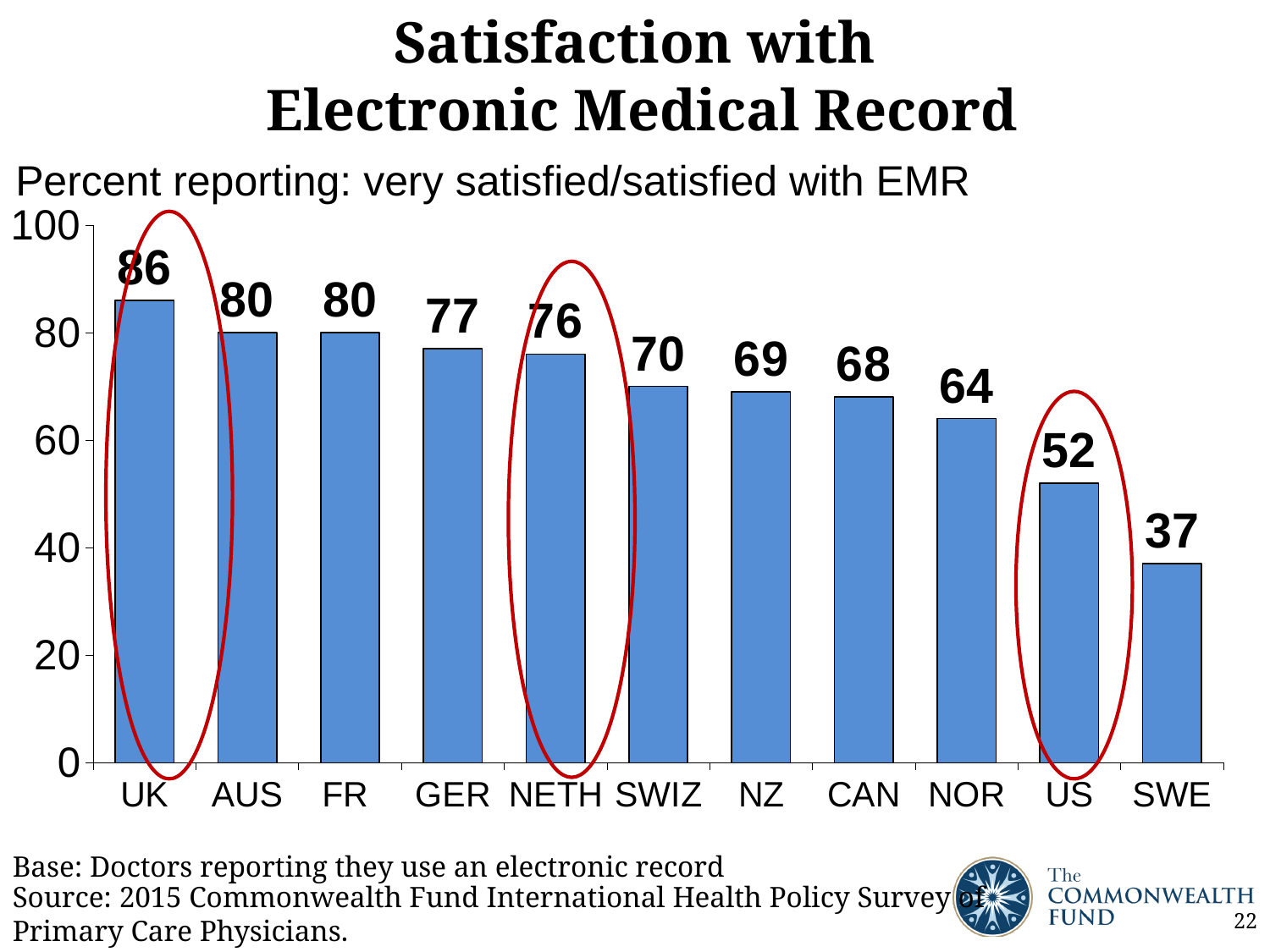
What is the value for the US? 52 Which country has the highest value? UK Which three countries are circled in red on the chart? UK, NETH, US What is the value for NETH? 76 What is the difference between the values for the UK and the US? 34 How many countries are shown on the chart? 11 Is the value for CAN greater or less than 60? greater What is the value for the UK? 86 Do the values rise or fall from left to right across the chart? fall Which is larger, the value for GER or the value for NOR? GER Which country has the lowest value? SWE What kind of chart is shown on the slide? bar chart